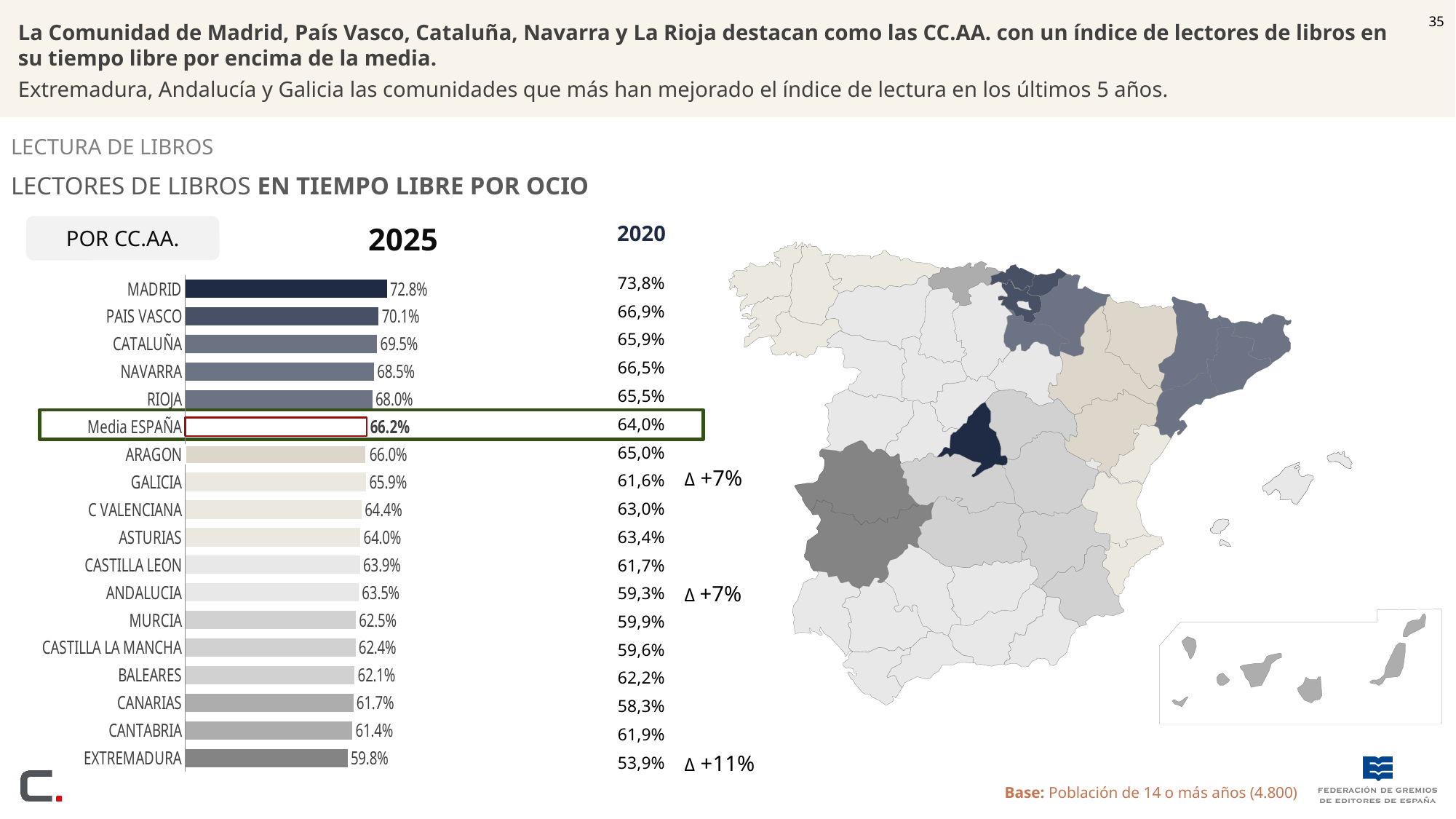
Which has a higher 2025 value, Murcia or Canarias? Murcia What is the difference between the 2025 values for Madrid and Extremadura? 13.0 percentage points What is the 2025 value shown for Media ESPAÑA? 66.2% Which community has the highest 2025 value in the bar chart? Madrid Which has a higher 2025 value, País Vasco or Cataluña? País Vasco Which community has the lowest 2025 value in the bar chart? Extremadura What is the 2020 value listed for Andalucía? 59,3% How many bars are shown in the 2025 bar chart, including Media ESPAÑA? 18 What kind of chart is used to show the 2025 values by community? Bar chart What is the 2025 value for Extremadura? 59.8% Do the 2025 values rise or fall going from the top bar to the bottom bar? Fall What is the 2025 value for Madrid in the bar chart? 72.8%